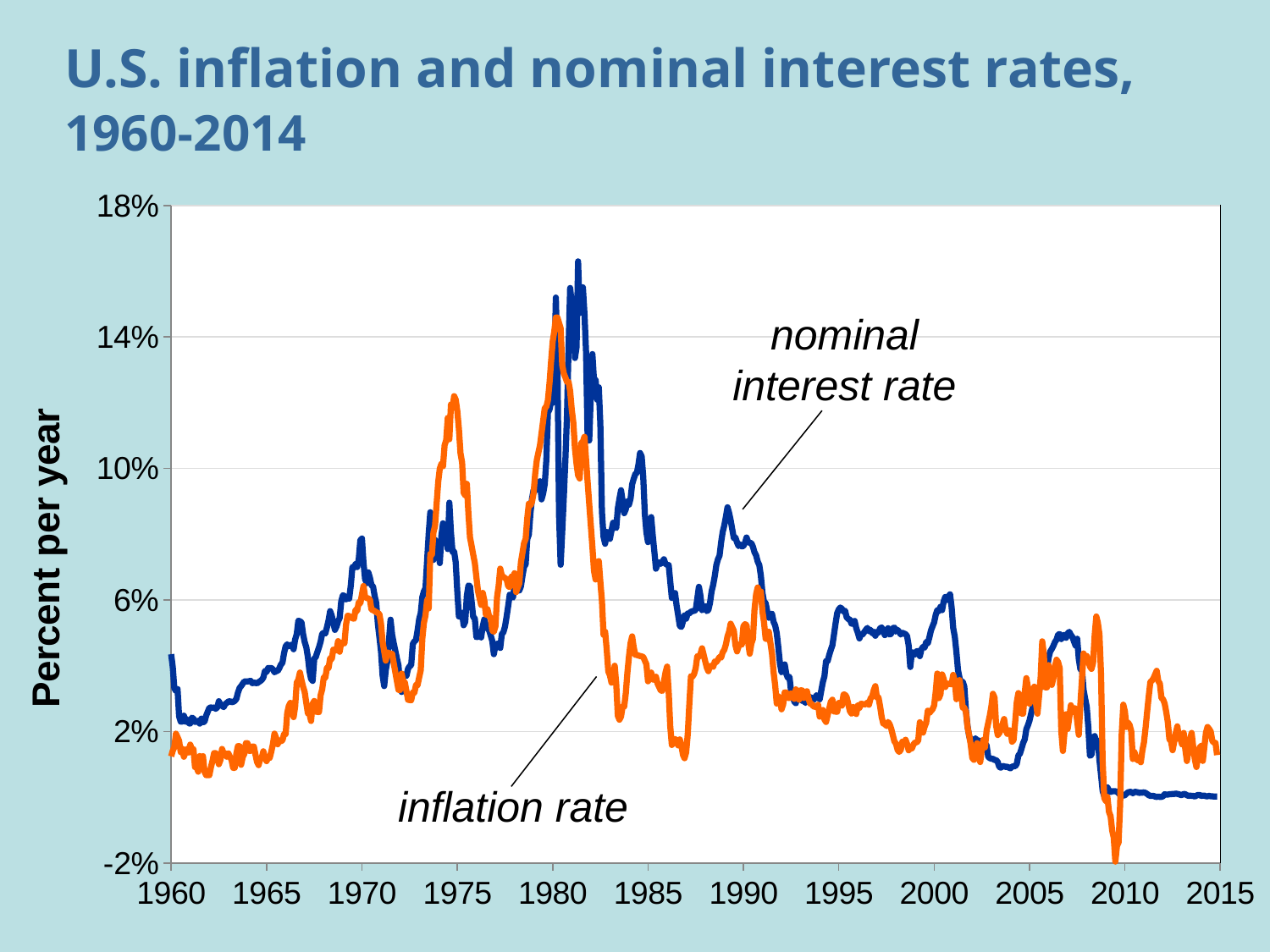
Is the peak value of the nominal interest rate around 1981 greater or less than 14%? greater In 1975, which is higher: the inflation rate or the nominal interest rate? inflation rate What kind of chart is shown on the slide? line chart What is the title of the chart? U.S. inflation and nominal interest rates, 1960-2014 Is the nominal interest rate in 2014 greater or less than 2%? less Is the inflation rate in 1965 greater or less than 2%? less In 1995, which is higher: the nominal interest rate or the inflation rate? nominal interest rate How many data series are plotted on the chart? 2 What is the label on the vertical axis? Percent per year Which series reaches the highest value anywhere on the chart? nominal interest rate